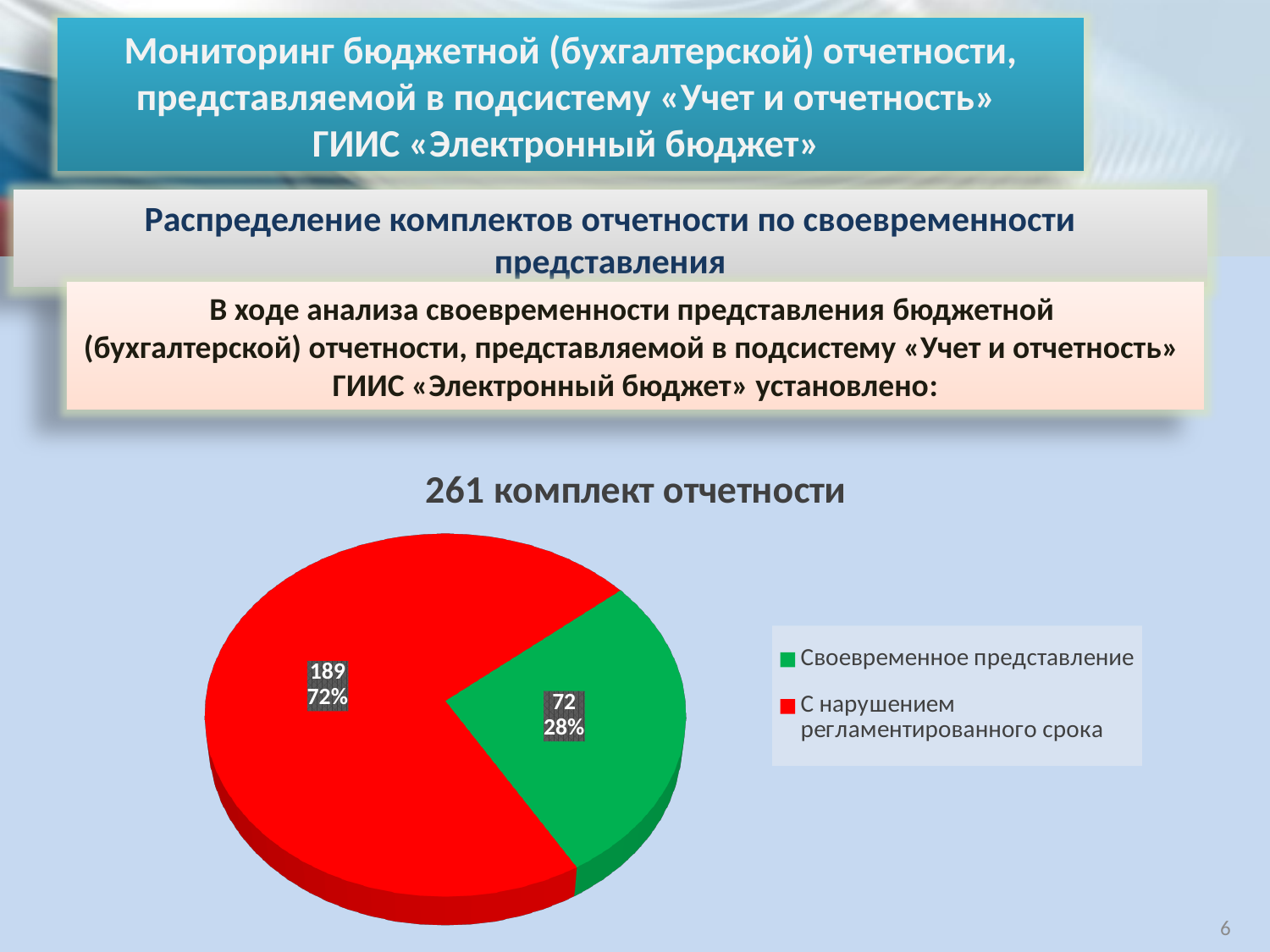
Which category has the largest slice? С нарушением регламентированного срока What is the difference between the values for «С нарушением регламентированного срока» and «Своевременное представление»? 117 What kind of chart is shown on the slide? pie chart What is the value for «Своевременное представление»? 72 What share of the pie does «Своевременное представление» take? 28% What colour is the slice for «Своевременное представление»? green How many slices does the pie chart have? 2 What is the title of the chart? 261 комплект отчетности What is the value for «С нарушением регламентированного срока»? 189 How many entries does the legend list? 2 What share of the pie does «С нарушением регламентированного срока» take? 72% Which category has the smallest slice? Своевременное представление